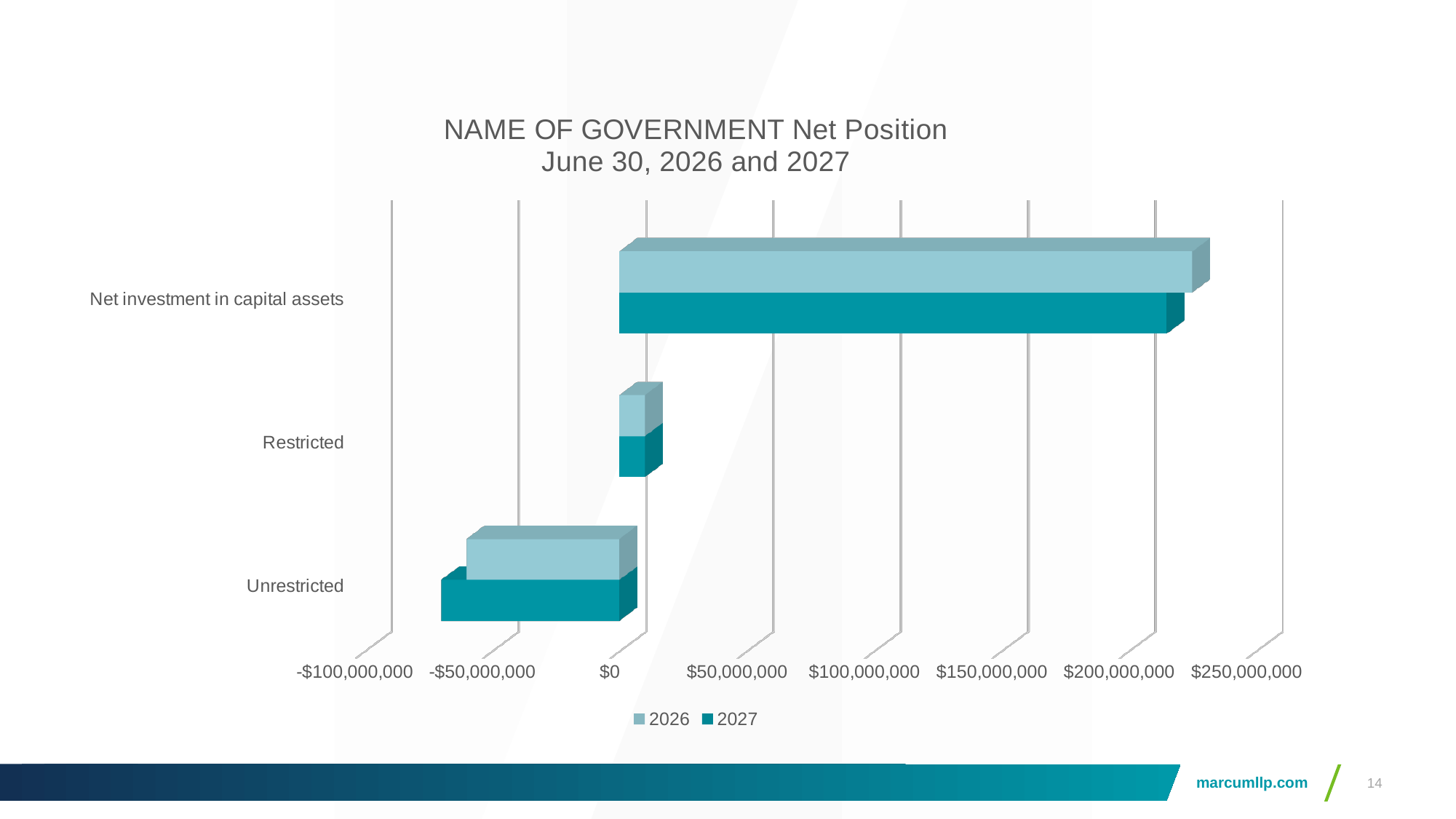
How many categories are shown on the vertical axis of the chart? 3 Which series is shown in the darker teal colour in the legend? 2027 Which category has the highest net position value in the chart? Net investment in capital assets Is the 2026 value for Unrestricted greater or less than -$100,000,000? greater Is the 2027 value for Unrestricted greater or less than -$50,000,000? less What kind of chart is shown on the slide? Bar chart For Net investment in capital assets, which year has the larger value, 2026 or 2027? 2026 Which category has the lowest net position value in the chart? Unrestricted How many series does the legend list? 2 What is the title of the chart? NAME OF GOVERNMENT Net Position June 30, 2026 and 2027 Is the 2026 value for Net investment in capital assets greater or less than $200,000,000? greater